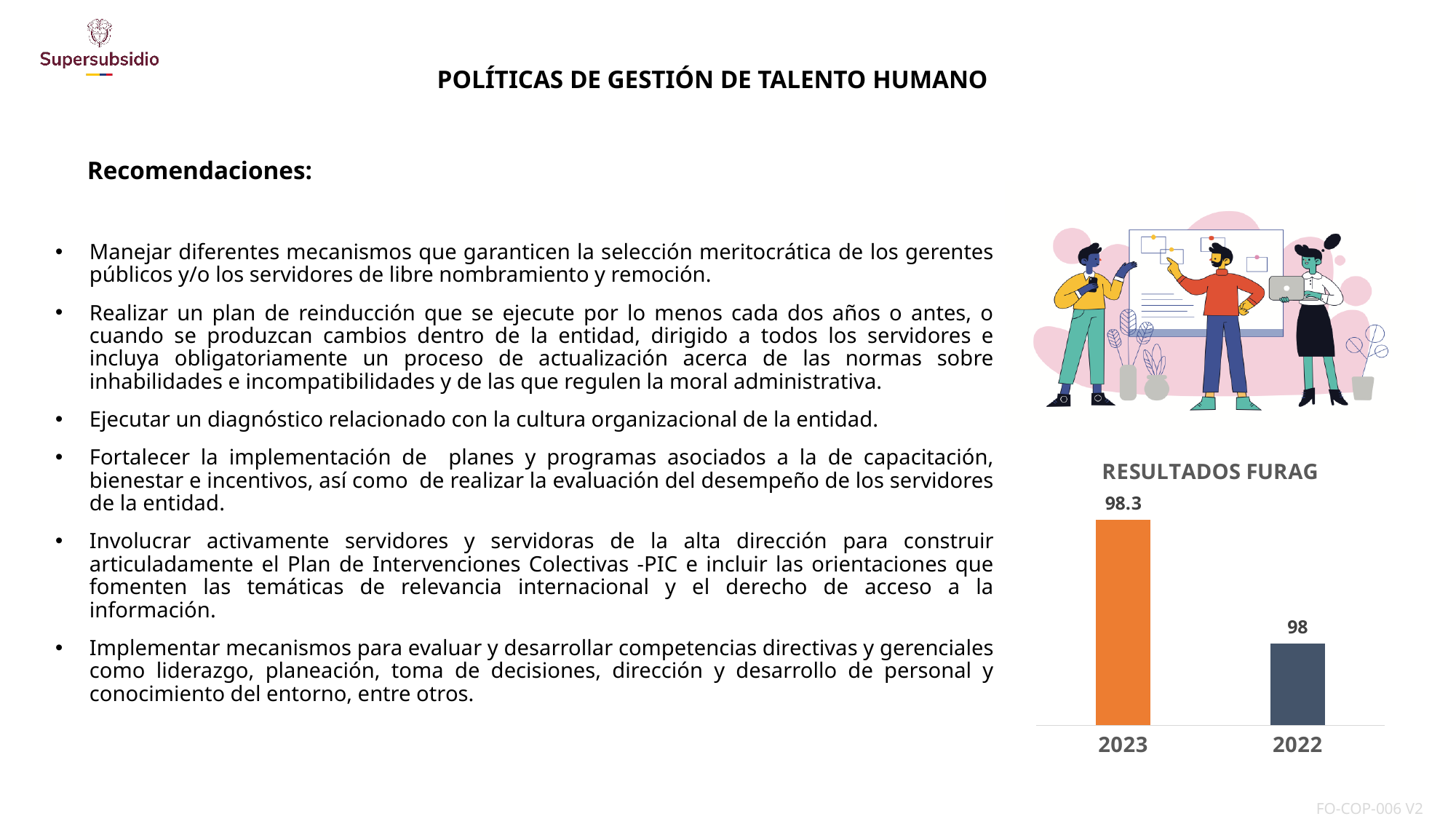
What is the value for 2022 in the RESULTADOS FURAG chart? 98 What colour is the bar for 2023 in the RESULTADOS FURAG chart? orange What is the value for 2023 in the RESULTADOS FURAG chart? 98.3 How many bars are shown in the RESULTADOS FURAG chart? 2 In the RESULTADOS FURAG chart, is the value for 2023 larger or smaller than the value for 2022? larger What is the title of the chart on the slide? RESULTADOS FURAG Which year has the lowest value in the RESULTADOS FURAG chart? 2022 What kind of chart is the RESULTADOS FURAG chart? bar chart What is the difference between the 2023 and 2022 values in the RESULTADOS FURAG chart? 0.3 Which year has the highest value in the RESULTADOS FURAG chart? 2023